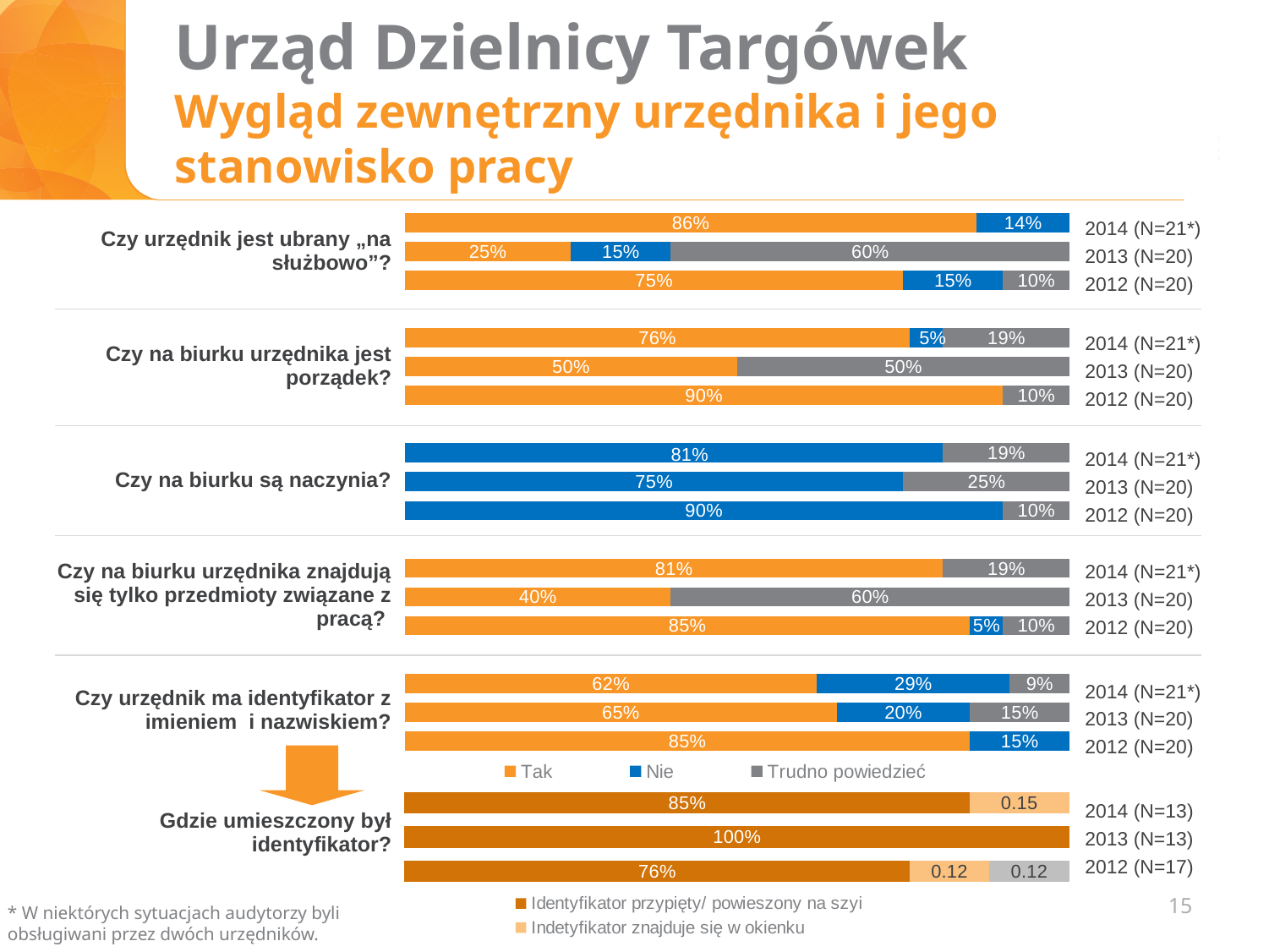
How many series does the legend list for the chart "Gdzie umieszczony był identyfikator?"? 2 In the chart "Czy na biurku urzędnika jest porządek?", what is the difference between the "Tak" share in 2014 (N=21*) and in 2013 (N=20)? 26 percentage points In the chart "Czy urzędnik ma identyfikator z imieniem i nazwiskiem?", what percentage answered "Nie" in 2014 (N=21*)? 29% In the chart "Czy urzędnik jest ubrany „na służbowo”?", what percentage answered "Tak" in 2014 (N=21*)? 86% In the chart "Czy urzędnik jest ubrany „na służbowo”?", what percentage answered "Trudno powiedzieć" in 2013 (N=20)? 60% In the chart "Czy urzędnik ma identyfikator z imieniem i nazwiskiem?", how many years (bars) are shown? 3 In the chart "Czy na biurku urzędnika jest porządek?", which year has the highest "Tak" share? 2012 (N=20) In the chart "Gdzie umieszczony był identyfikator?", what is the value for "Identyfikator przypięty/ powieszony na szyi" in 2013 (N=13)? 100% In the chart "Czy na biurku są naczynia?", which year has the lowest "Trudno powiedzieć" share? 2012 (N=20) In the chart "Czy na biurku są naczynia?", what percentage answered "Nie" in 2013 (N=20)? 75% In the chart "Czy na biurku urzędnika znajdują się tylko przedmioty związane z pracą?", is the "Tak" share larger in 2014 (N=21*) or in 2013 (N=20)? 2014 (N=21*) What type of chart is used for "Czy urzędnik jest ubrany „na służbowo”?"? Stacked horizontal bar chart